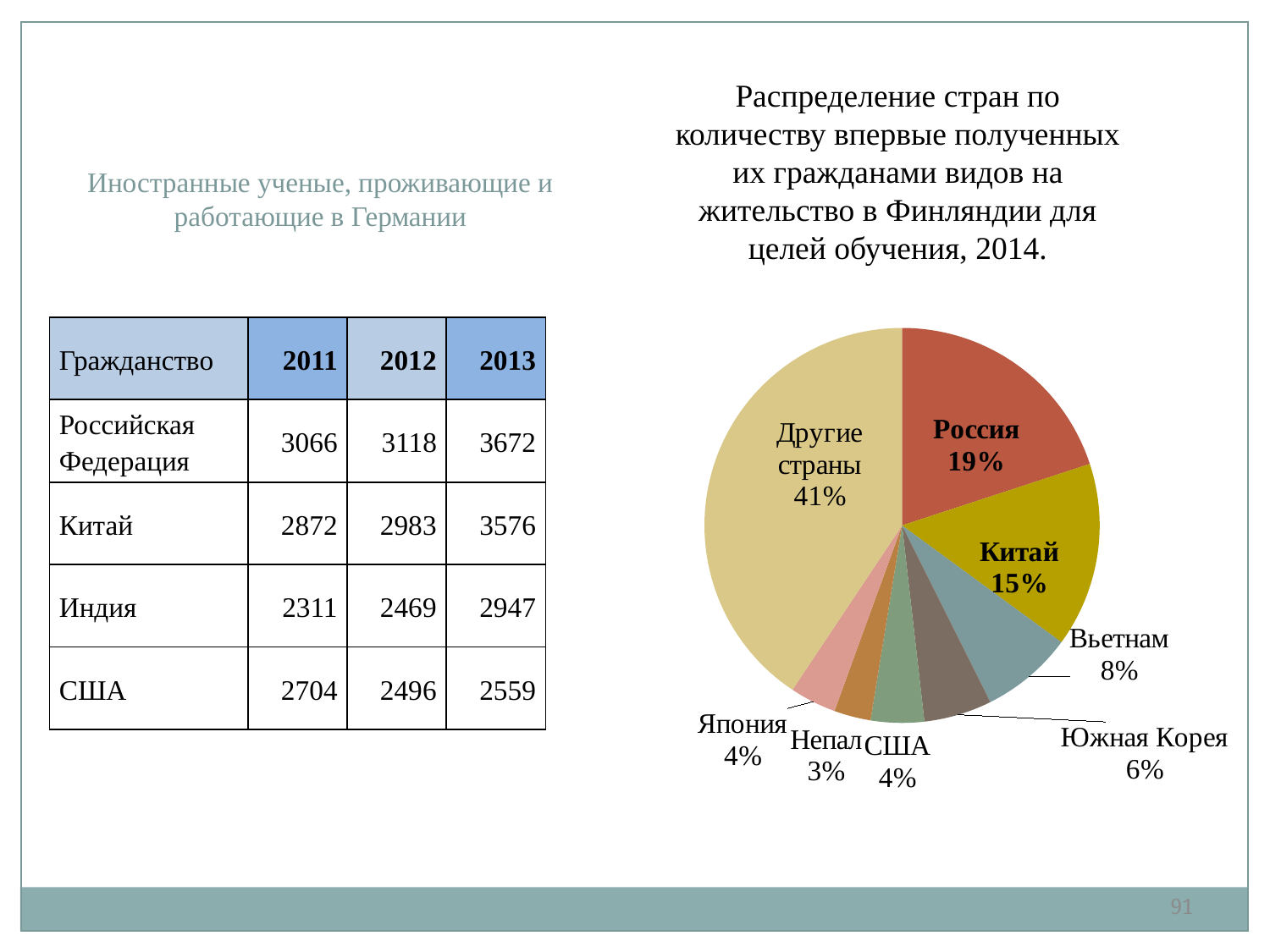
In the pie chart, what is the difference in percentage points between Россия and Китай? 4 In the pie chart, what share does Непал have? 3% In the pie chart, which slice is the largest? Другие страны In the pie chart, what share does Вьетнам have? 8% What kind of chart is shown on the slide? Pie chart In the pie chart, how many slices are there? 8 In the pie chart, what share does Китай have? 15% What year is given in the title of the pie chart? 2014 In the pie chart, which has a larger share, Вьетнам or Южная Корея? Вьетнам In the pie chart, which slice is the smallest? Непал